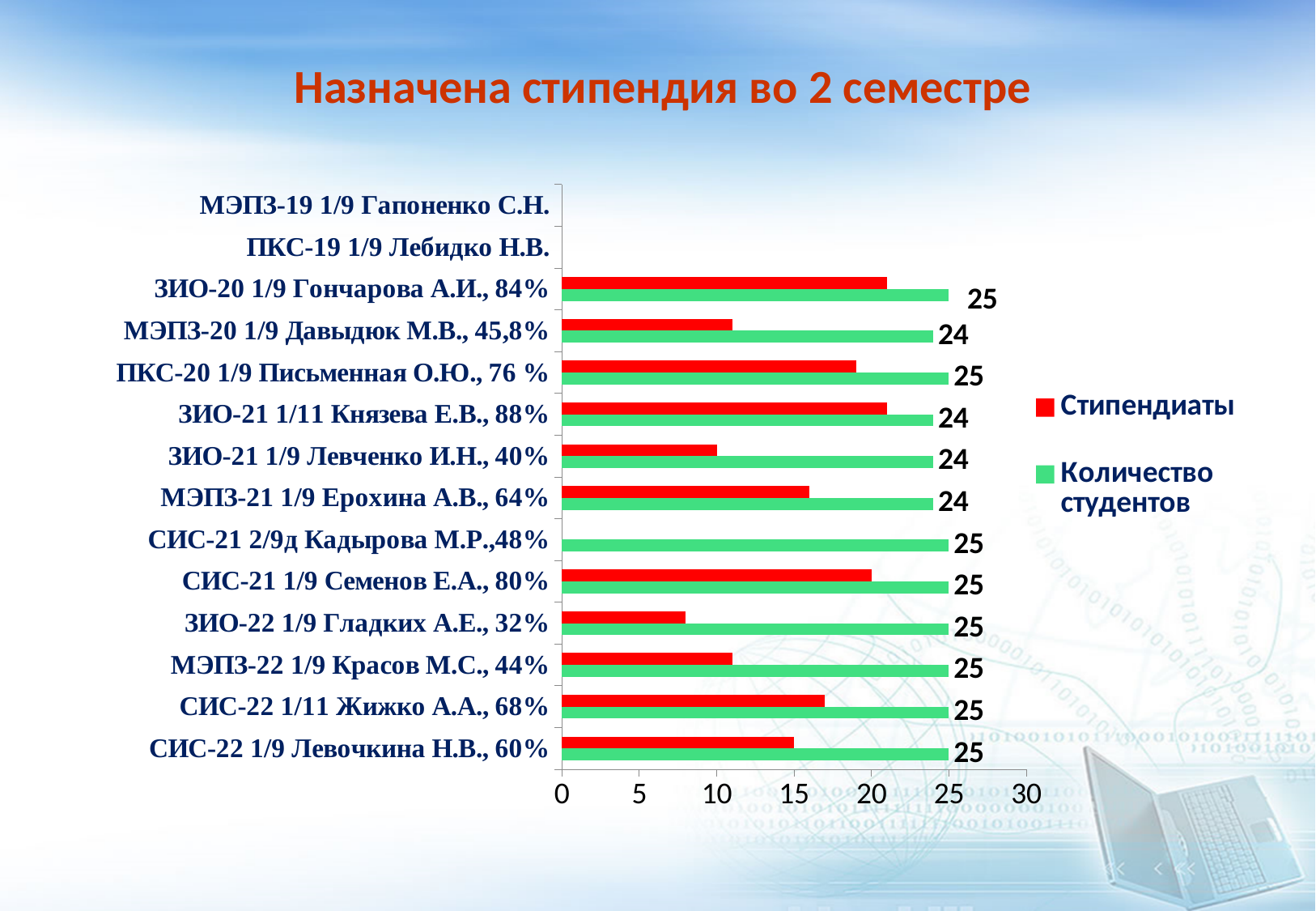
What is the value of Количество студентов for СИС-22 1/9 Левочкина Н.В., 60%? 25 Which has the larger Стипендиаты value: ЗИО-20 1/9 Гончарова А.И., 84% or МЭПЗ-20 1/9 Давыдюк М.В., 45,8%? ЗИО-20 1/9 Гончарова А.И., 84% What is the difference between Количество студентов for ЗИО-20 1/9 Гончарова А.И., 84% and for ЗИО-21 1/11 Князева Е.В., 88%? 1 How many series does the legend list? 2 Which series is shown in green according to the legend? Количество студентов What is the value of Количество студентов for МЭПЗ-20 1/9 Давыдюк М.В., 45,8%? 24 How many categories are listed on the vertical axis of the chart? 14 Is the Стипендиаты value for ЗИО-22 1/9 Гладких А.Е., 32% greater or less than 10? less Is the Стипендиаты value for ЗИО-20 1/9 Гончарова А.И., 84% greater or less than 20? greater What is the title of the slide? Назначена стипендия во 2 семестре What kind of chart is shown on the slide? bar chart What is the value of Количество студентов for ЗИО-21 1/9 Левченко И.Н., 40%? 24